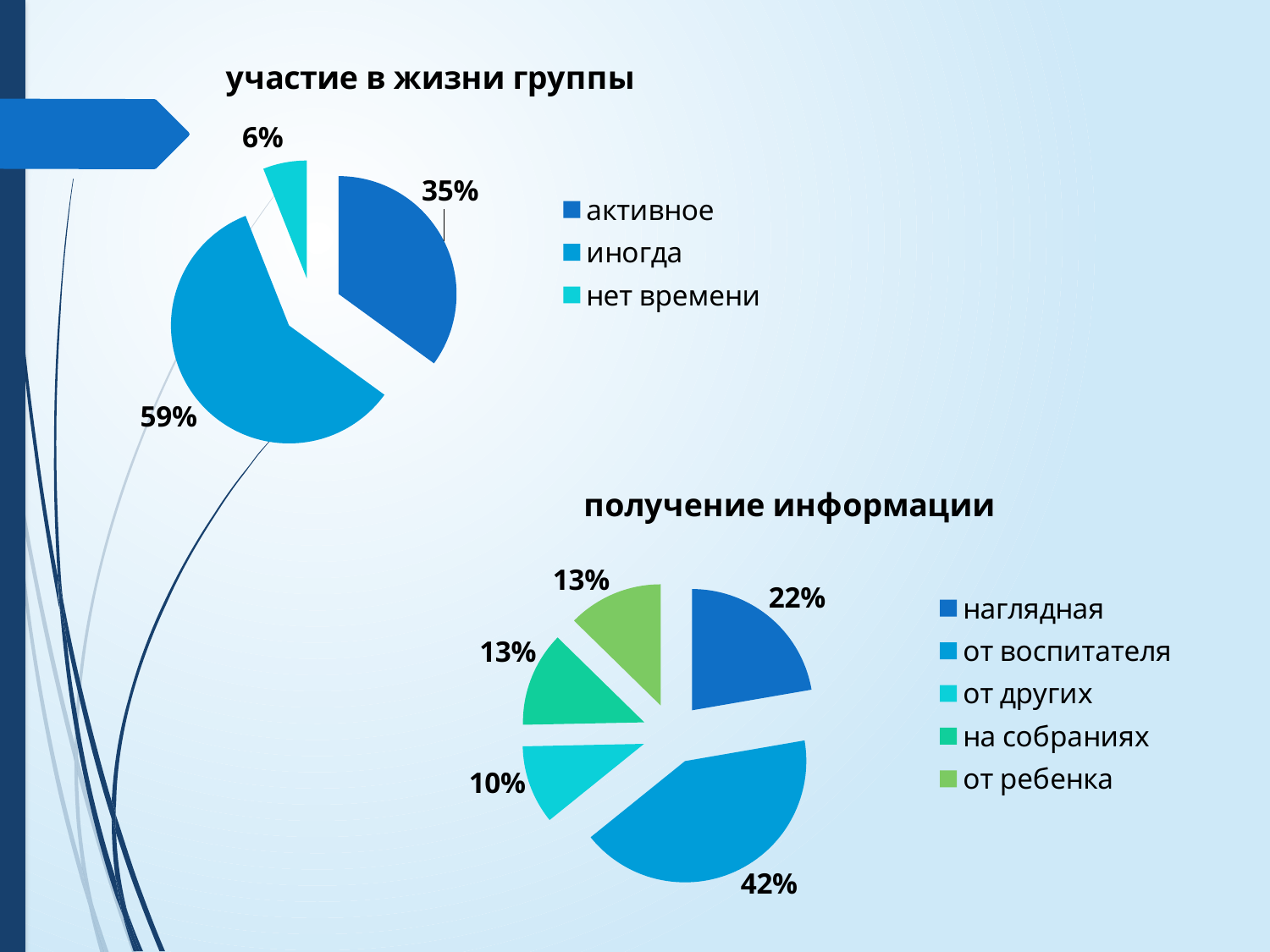
In the chart titled "участие в жизни группы", how many categories does the legend list? 3 In the chart titled "получение информации", what share is labelled for "от других"? 10% In the chart titled "получение информации", which category has the largest slice? от воспитателя In the chart titled "получение информации", how many categories does the legend list? 5 In the chart titled "участие в жизни группы", what share is labelled for "нет времени"? 6% In the chart titled "участие в жизни группы", which category has the largest slice? иногда In the chart titled "участие в жизни группы", what share is labelled for "иногда"? 59% In the chart titled "получение информации", which is larger, the share for "наглядная" or the share for "от других"? наглядная In the chart titled "участие в жизни группы", which category has the smallest slice? нет времени In the chart titled "получение информации", what share is labelled for "от воспитателя"? 42% In the chart titled "участие в жизни группы", what is the difference between the shares for "иногда" and "активное"? 24% What type of chart is the chart titled "получение информации"? pie chart